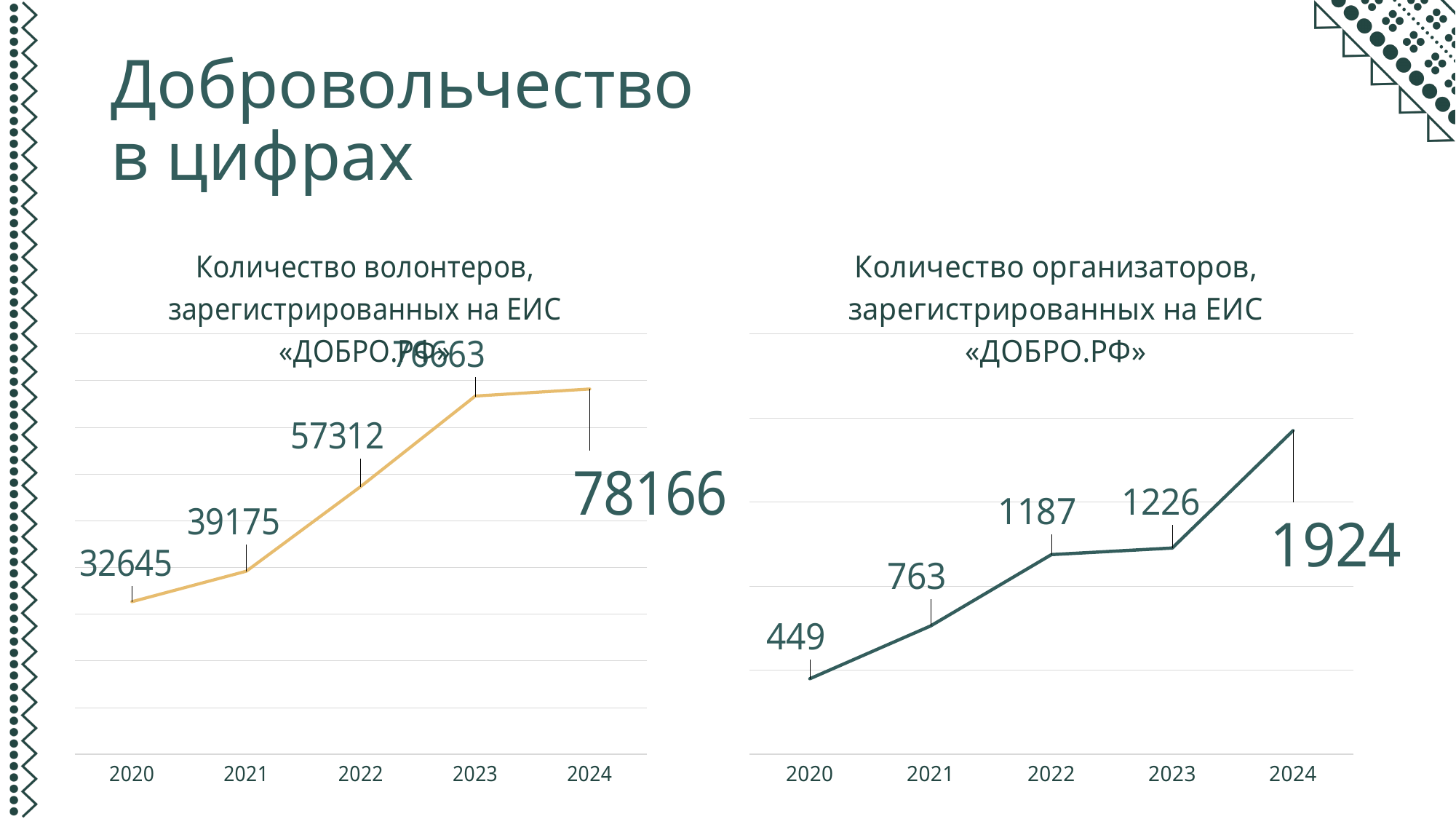
In the right chart (organizers), how many years are plotted on the x axis? 5 In the left chart (volunteers), what is the difference between the 2022 and 2021 values? 18137 What type of chart is the left chart, 'Количество волонтеров, зарегистрированных на ЕИС «ДОБРО.РФ»'? line chart In the left chart (volunteers), which year has the lowest value? 2020 In the right chart (organizers), which year has the highest value? 2024 In the right chart (organizers), what is the value for 2021? 763 In the right chart (organizers), what is the value for 2023? 1226 In the left chart (volunteers), what is the value for 2022? 57312 In the right chart (organizers), do the values rise or fall from 2020 to 2024? rise In the left chart (volunteers), what is the value for 2020? 32645 In the right chart (organizers), what is the difference between the 2024 and 2023 values? 698 In the left chart (volunteers), what is the value for 2024? 78166